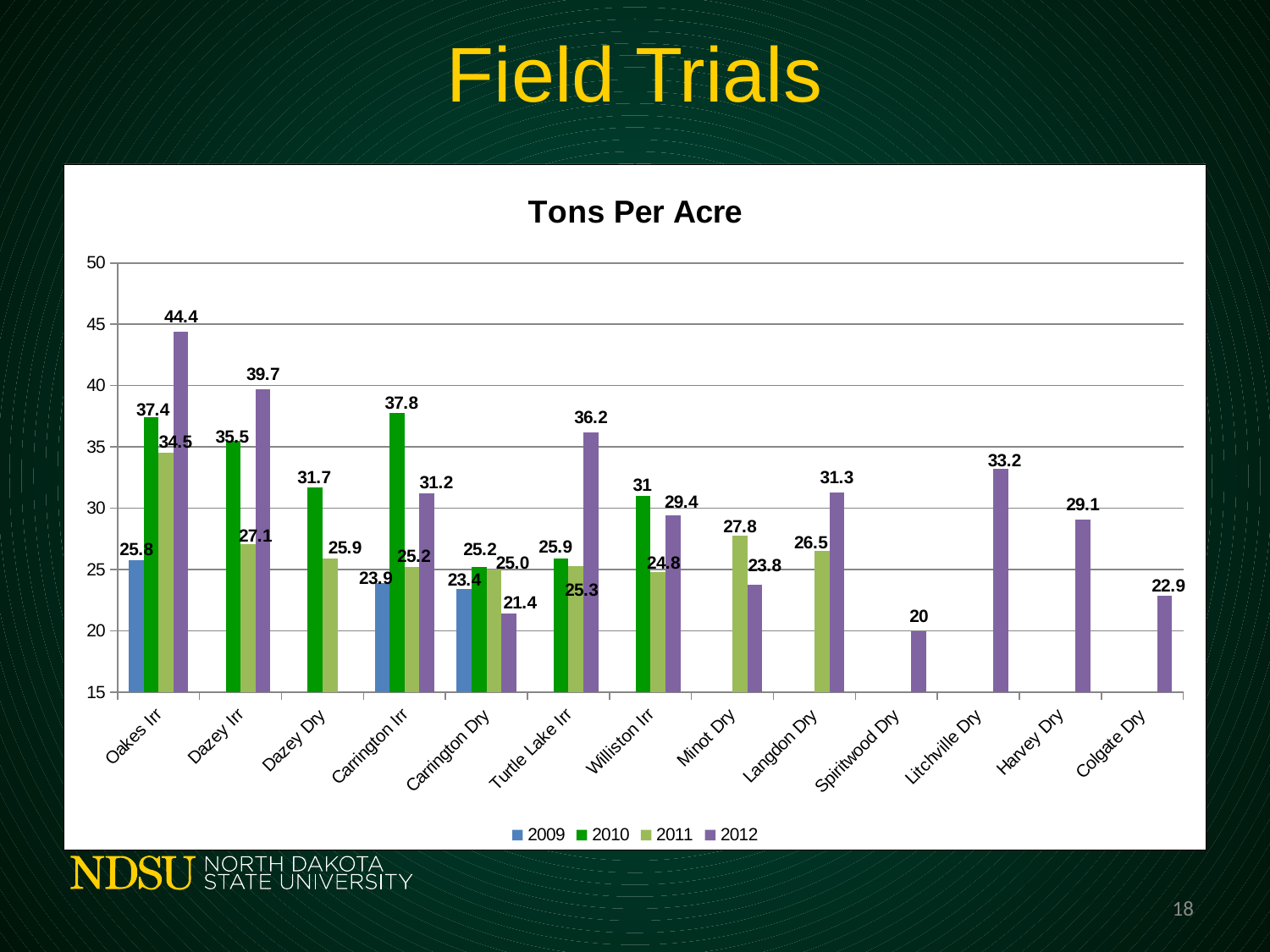
What is the title of the chart? Tons Per Acre Which is larger, the 2010 value for Williston Irr or the 2012 value for Williston Irr? 2010 What is the difference between the 2012 values for Dazey Irr and Carrington Irr? 8.5 Which location has the lowest 2012 value? Spiritwood Dry What is the 2012 value for Spiritwood Dry? 20 How many series does the legend list? 4 What kind of chart is this? Bar chart Which location has the highest 2012 value? Oakes Irr What is the 2010 value for Carrington Irr? 37.8 How many locations are shown on the x axis? 13 What is the 2011 value for Minot Dry? 27.8 What is the 2012 value for Oakes Irr? 44.4